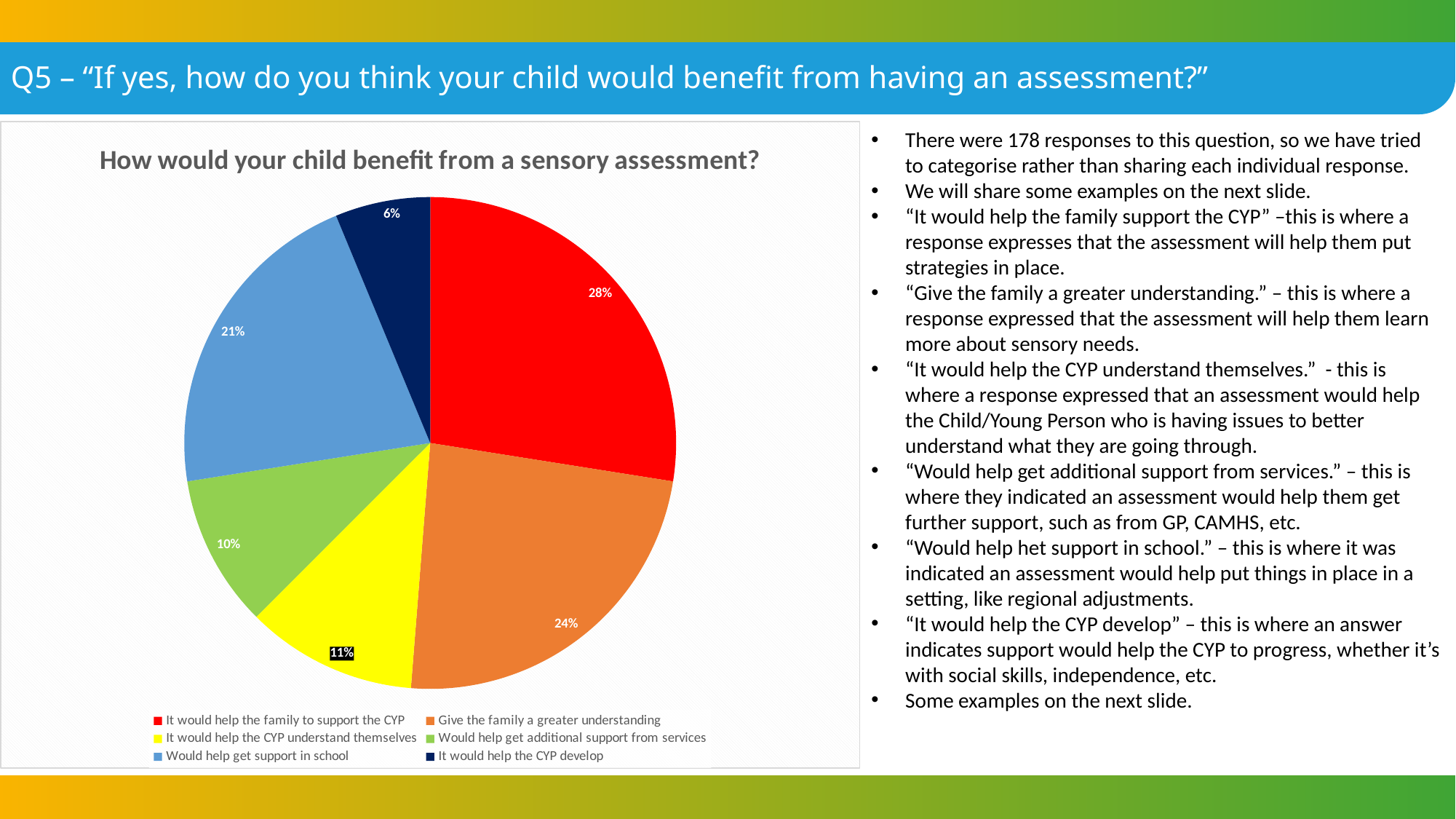
What percentage of responses fall under "It would help the CYP develop"? 6% What percentage of responses fall under "Would help get support in school"? 21% What percentage of responses fall under "Give the family a greater understanding"? 24% What is the difference in percentage points between "It would help the family to support the CYP" and "Give the family a greater understanding"? 4 What kind of chart is shown on the slide? Pie chart How many categories does the pie chart show? 6 Which category has the largest share of the pie? It would help the family to support the CYP Which is larger: the share for "It would help the CYP understand themselves" or the share for "Would help get additional support from services"? It would help the CYP understand themselves What colour is the slice for "Would help get support in school"? Blue Which category has the smallest share of the pie? It would help the CYP develop What percentage of responses fall under "It would help the family to support the CYP"? 28% What is the title of the chart? How would your child benefit from a sensory assessment?